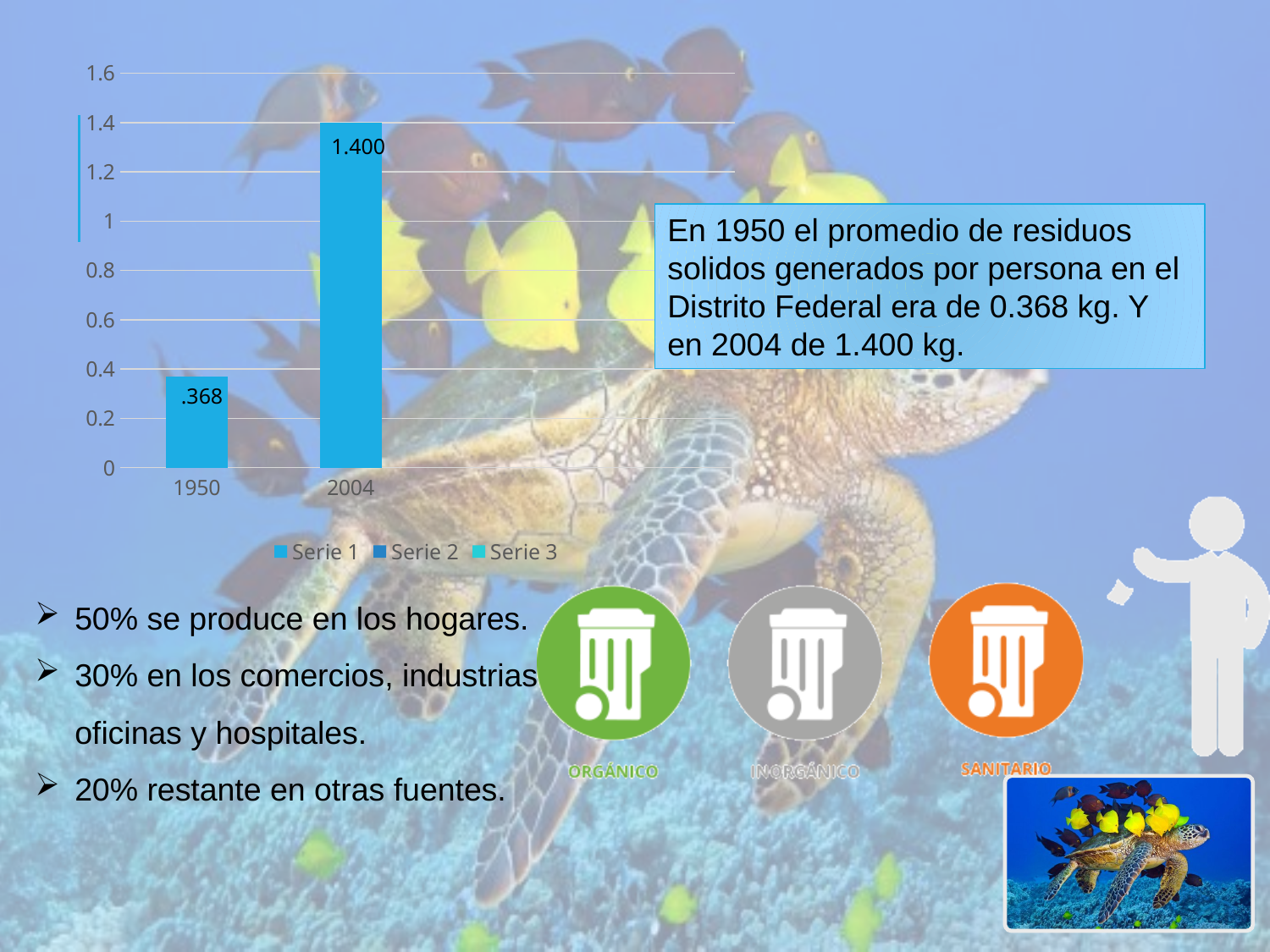
What value is shown for 2004 in the bar chart? 1.400 Is the value for 1950 greater or less than 0.4? less How many series does the chart legend list? 3 What is the difference between the values for 2004 and 1950 in the chart? 1.032 Which category has the highest bar in the chart? 2004 Do the values rise or fall from 1950 to 2004 in the chart? rise How many categories are shown on the x axis of the chart? 2 What value is shown for 1950 in the bar chart? .368 Which category has the lowest bar in the chart? 1950 Which is larger in the chart, the value for 1950 or the value for 2004? 2004 Is the value for 2004 greater or less than 1? greater What kind of chart is shown on the slide? bar chart